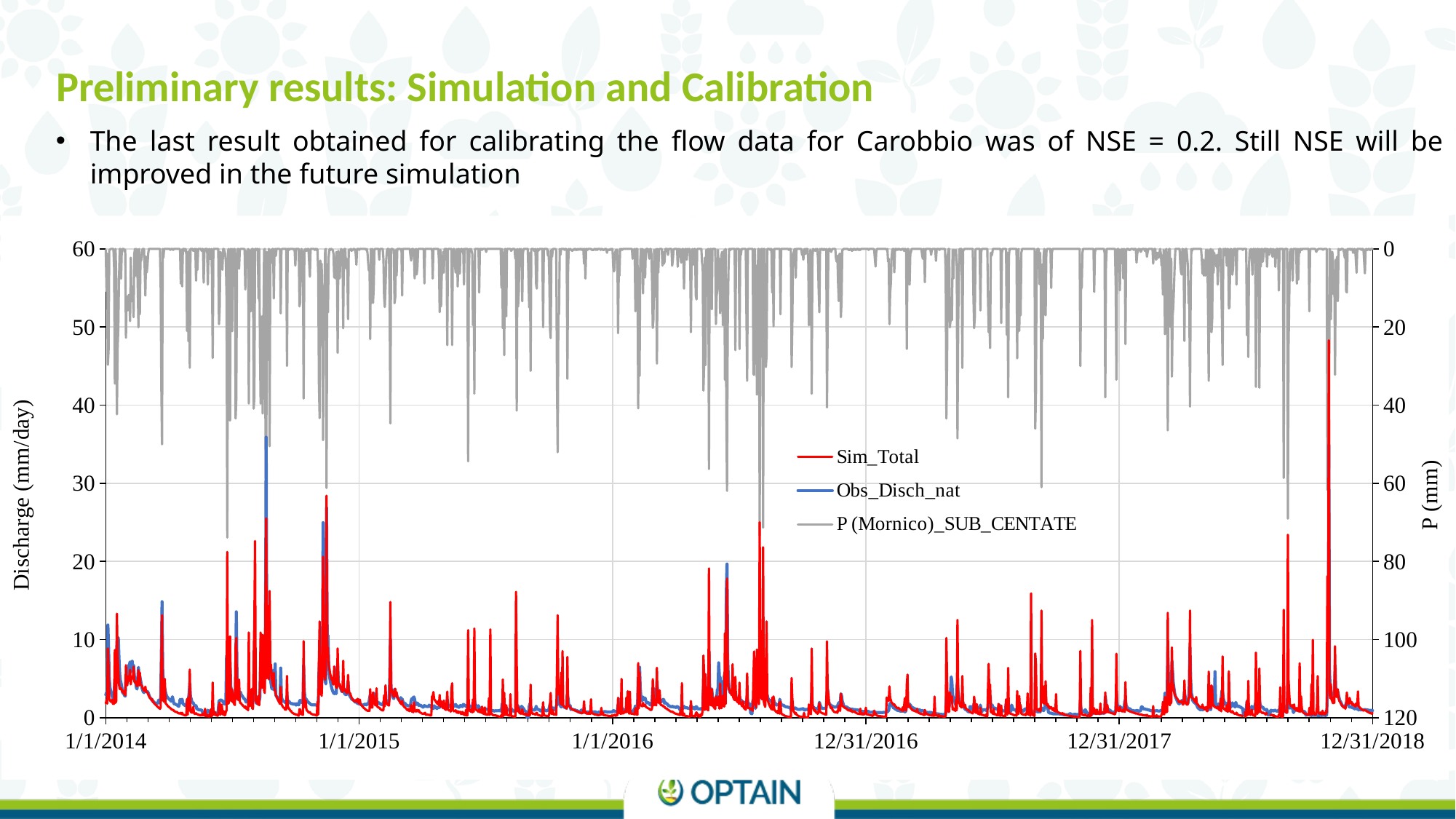
What is the label of the left vertical axis of the chart? Discharge (mm/day) Is the highest peak of the Obs_Disch_nat series, in mid-2014, greater or less than 30 mm/day? greater Which series in the chart is drawn in red? Sim_Total What is the first date shown on the x axis of the chart? 1/1/2014 What is the label of the right vertical axis of the chart? P (mm) Is the highest peak of the Sim_Total series, near the end of 2018, greater or less than 40 mm/day? greater What is the last date shown on the x axis of the chart? 12/31/2018 Which series in the chart is drawn in blue? Obs_Disch_nat What is the maximum value shown on the left vertical axis (Discharge) of the chart? 60 What kind of chart is shown on the slide? line chart Which series in the chart is drawn in gray? P (Mornico)_SUB_CENTATE How many series does the chart legend list? 3